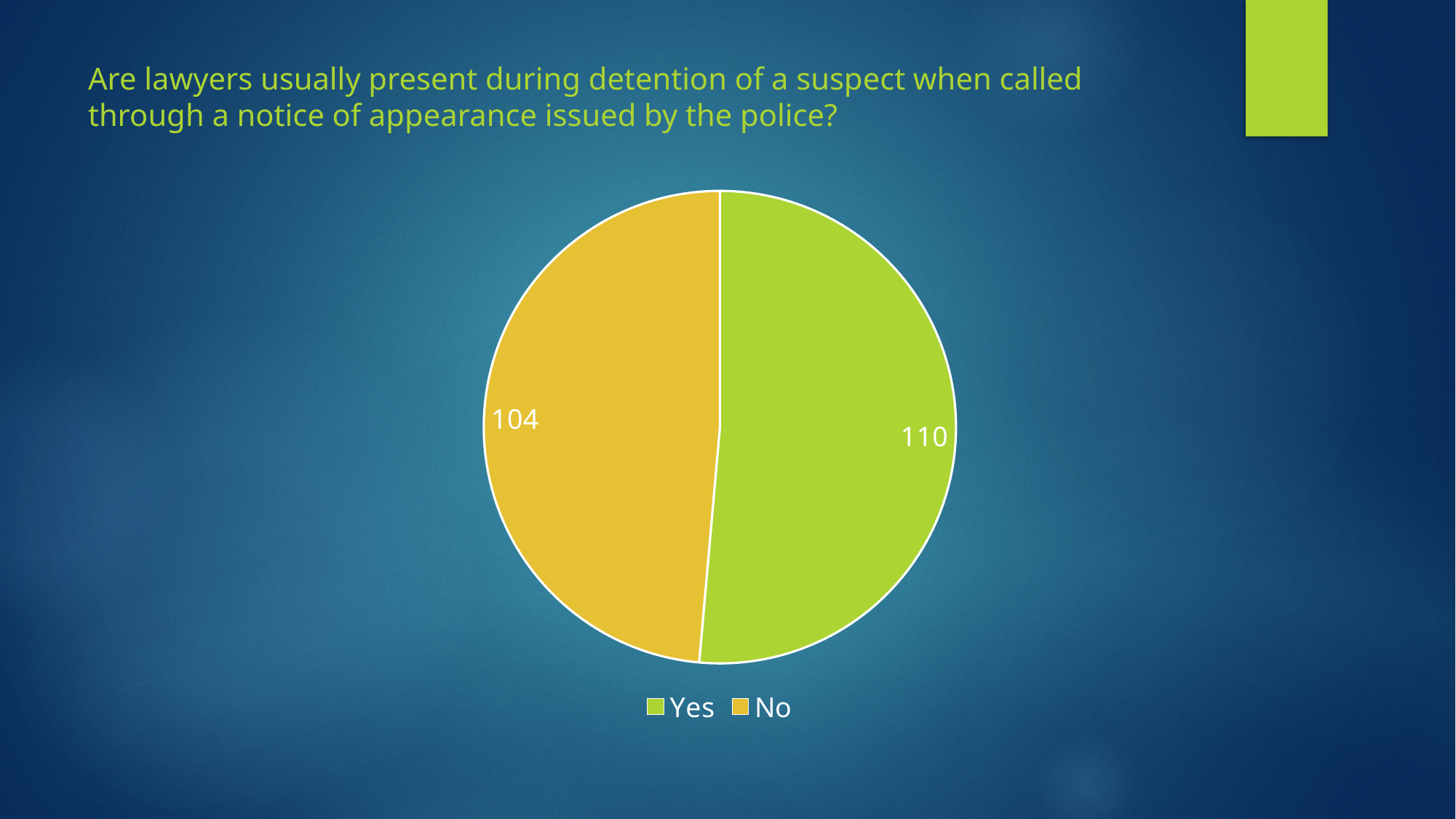
Which category has the smaller slice in the pie chart? No Is the value for Yes larger or smaller than the value for No? larger What are the two legend entries of the pie chart? Yes and No How many entries does the legend list? 2 How many slices does the pie chart have? 2 What is the value for No in the pie chart? 104 What is the total of the two values shown in the pie chart? 214 What colour is the Yes slice in the pie chart? green Which category has the larger slice in the pie chart? Yes What is the value for Yes in the pie chart? 110 What is the difference between the Yes and No values in the pie chart? 6 What kind of chart is shown on the slide? pie chart